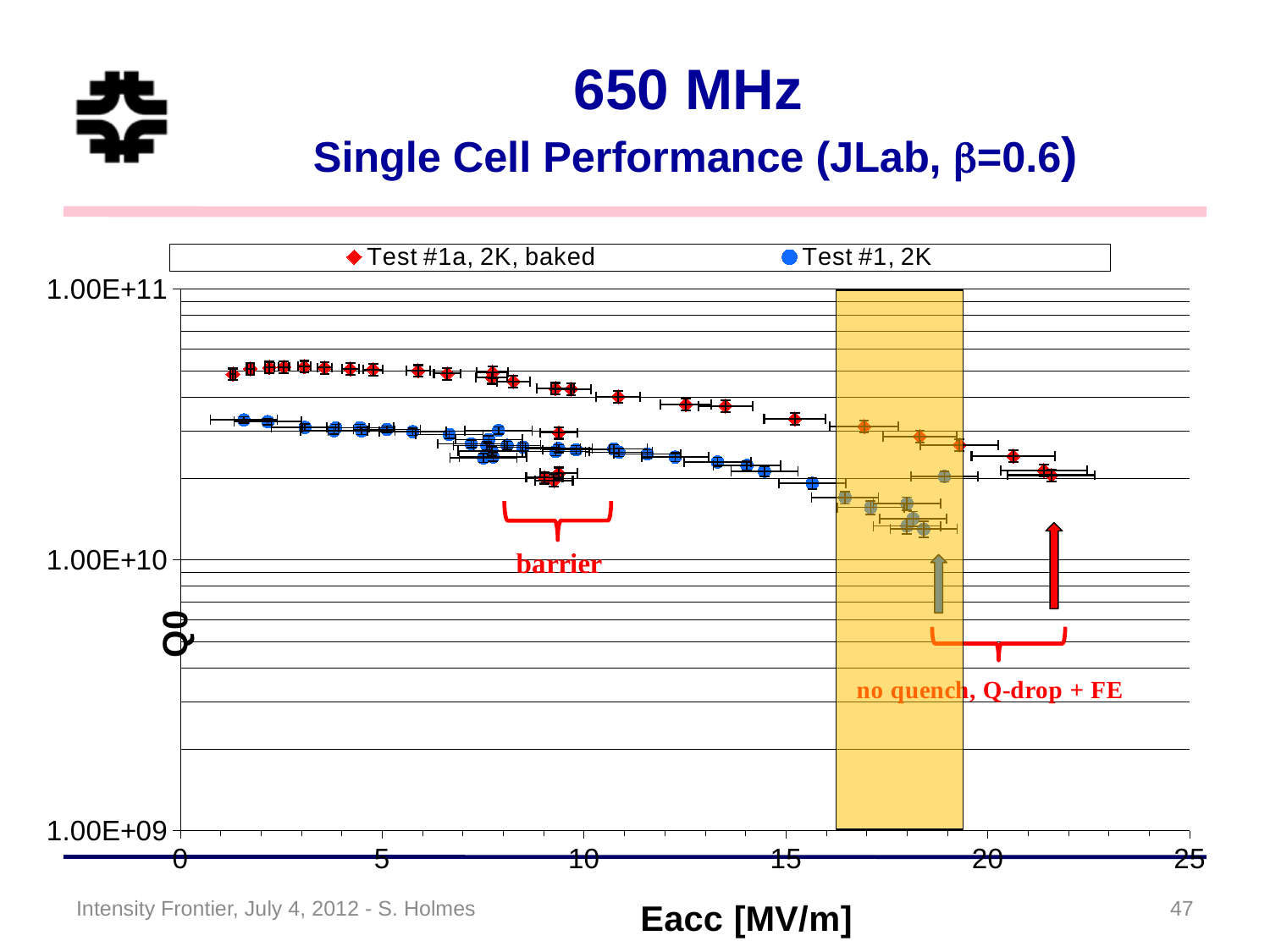
Does Q0 for the Test #1, 2K series rise or fall as Eacc increases? fall How many series does the chart legend list? 2 What kind of chart is shown on the slide? scatter chart What are the two series named in the chart legend? Test #1a, 2K, baked; Test #1, 2K Is the Q0 value for the Test #1a, 2K, baked series at about 20 MV/m greater or less than 1.00E+11? less Does Q0 for the Test #1a, 2K, baked series rise or fall as Eacc increases? fall Is the Q0 value for the Test #1, 2K series at about 15 MV/m greater or less than 1.00E+10? greater Is the Q0 value for the Test #1a, 2K, baked series at about 5 MV/m greater or less than 1.00E+10? greater What is the label of the x axis of the chart? Eacc [MV/m] What is the highest value shown on the y axis of the chart? 1.00E+11 Which series reaches the highest Eacc value on the chart? Test #1a, 2K, baked At an Eacc of about 10 MV/m, which series has the higher Q0: Test #1a, 2K, baked or Test #1, 2K? Test #1a, 2K, baked